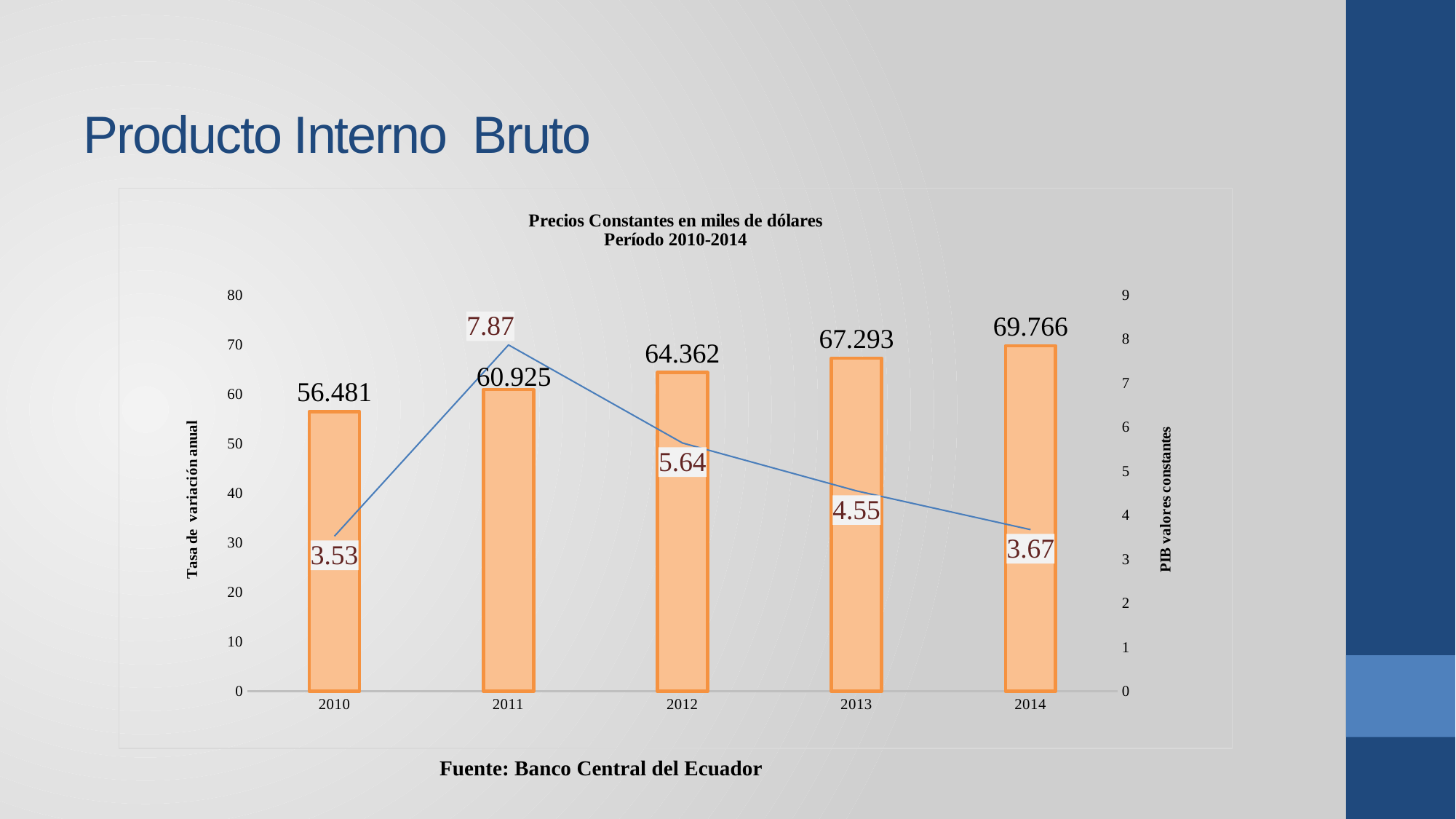
What source is cited below the chart? Banco Central del Ecuador What is the value shown on the line for 2013? 4.55 Which year has the lowest value on the line? 2010 Which year has the tallest bar? 2014 What is the difference between the bar values for 2014 and 2010? 13.285 Is the bar value for 2011 greater or less than 60 on the left axis? greater What is the value shown on the line for 2011? 7.87 What is the title of the chart? Precios Constantes en miles de dólares Período 2010-2014 Do the bar values rise or fall from 2010 to 2014? rise How many years are shown on the x axis? 5 Which is larger, the line value for 2012 or the line value for 2014? 2012 What is the value shown on the bar for 2012? 64.362